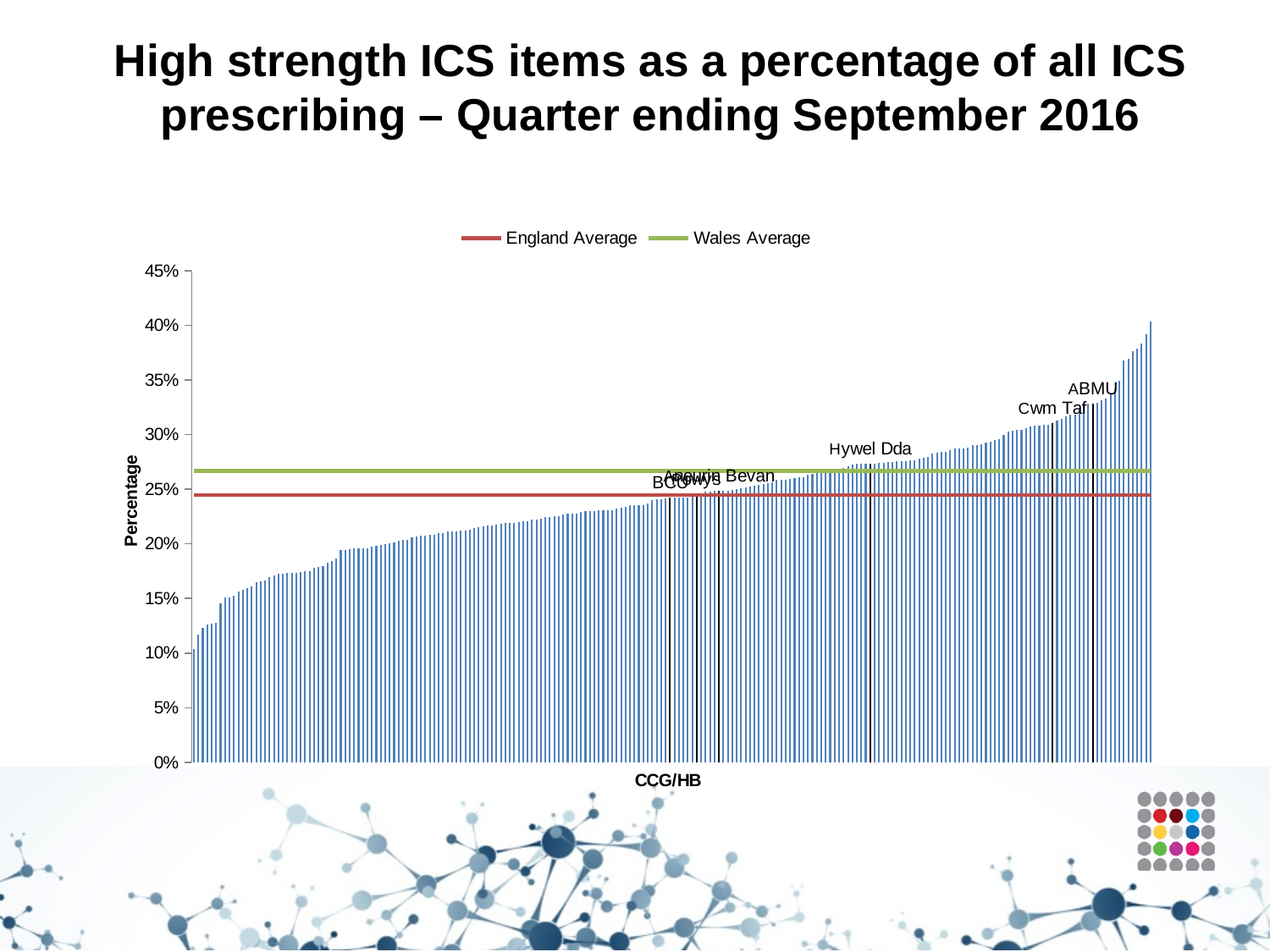
Is the value for Hywel Dda greater or less than 30%? less What kind of chart is shown on the slide? bar chart Is the value for ABMU greater or less than 30%? greater What colour is the Wales Average line? green Which has the larger value, ABMU or BCU? ABMU Is the value for BCU greater or less than 25%? less Do the bar values rise or fall from left to right along the x axis? rise How many series does the legend list? 2 Of the labelled health boards (BCU, Powys, Aneurin Bevan, Hywel Dda, Cwm Taf, ABMU), which has the highest value? ABMU Which is higher, the Wales Average line or the England Average line? Wales Average What is the label of the y axis? Percentage